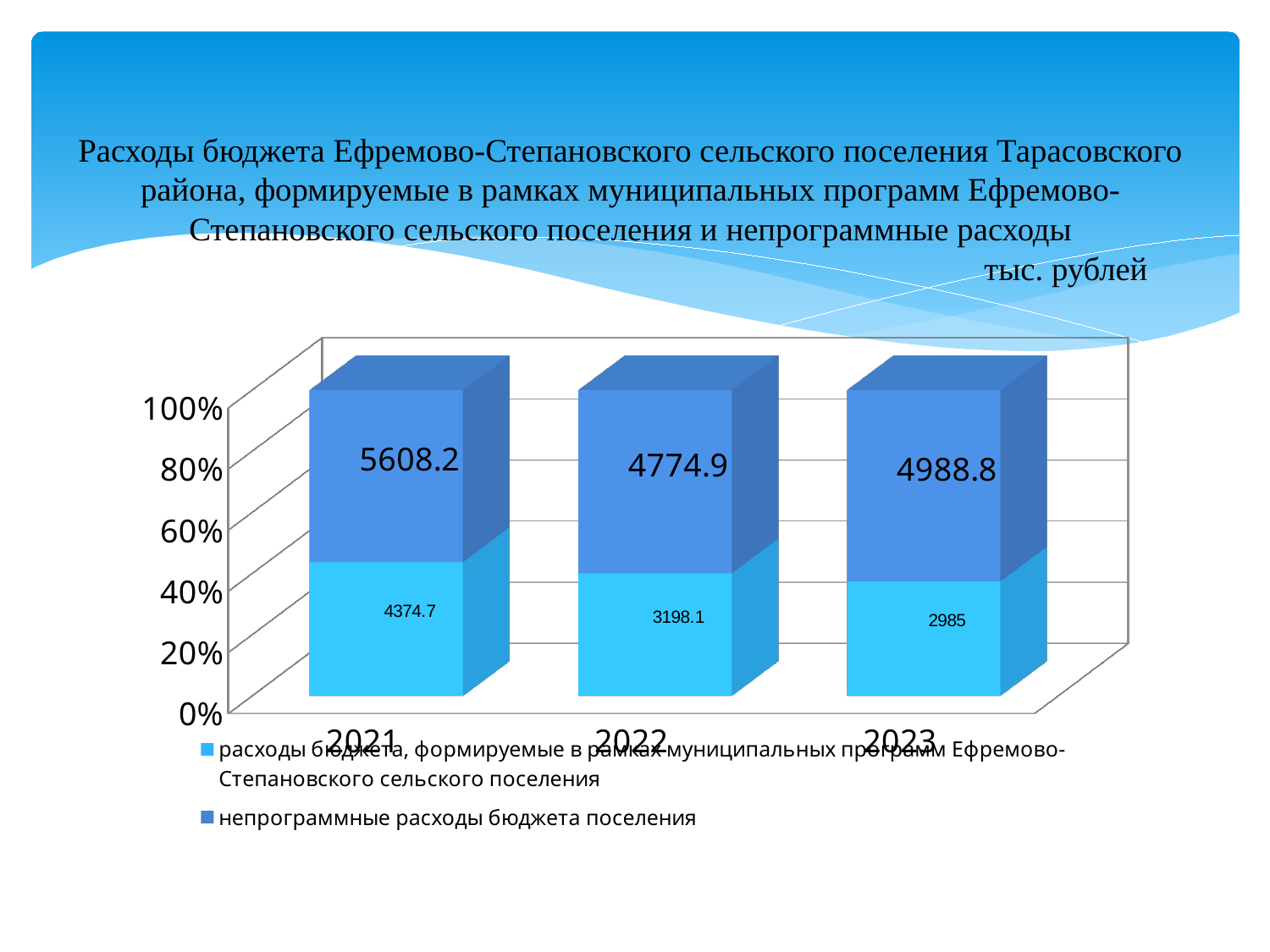
How many years are shown on the x axis? 3 In which year are непрограммные расходы бюджета поселения the lowest? 2022 Which is larger in 2022: непрограммные расходы бюджета поселения or расходы в рамках муниципальных программ? непрограммные расходы бюджета поселения What is the value of непрограммные расходы бюджета поселения for 2023? 4988.8 What kind of chart is shown on the slide? Stacked bar chart What is the value of непрограммные расходы бюджета поселения for 2021? 5608.2 What is the value of расходы бюджета, формируемые в рамках муниципальных программ for 2022? 3198.1 What is the difference between непрограммные расходы and программные расходы in 2023? 2003.8 What is the value of расходы бюджета, формируемые в рамках муниципальных программ for 2023? 2985 In which year are расходы бюджета, формируемые в рамках муниципальных программ the highest? 2021 Do расходы бюджета, формируемые в рамках муниципальных программ rise or fall from 2021 to 2023? Fall How many series does the legend list? 2